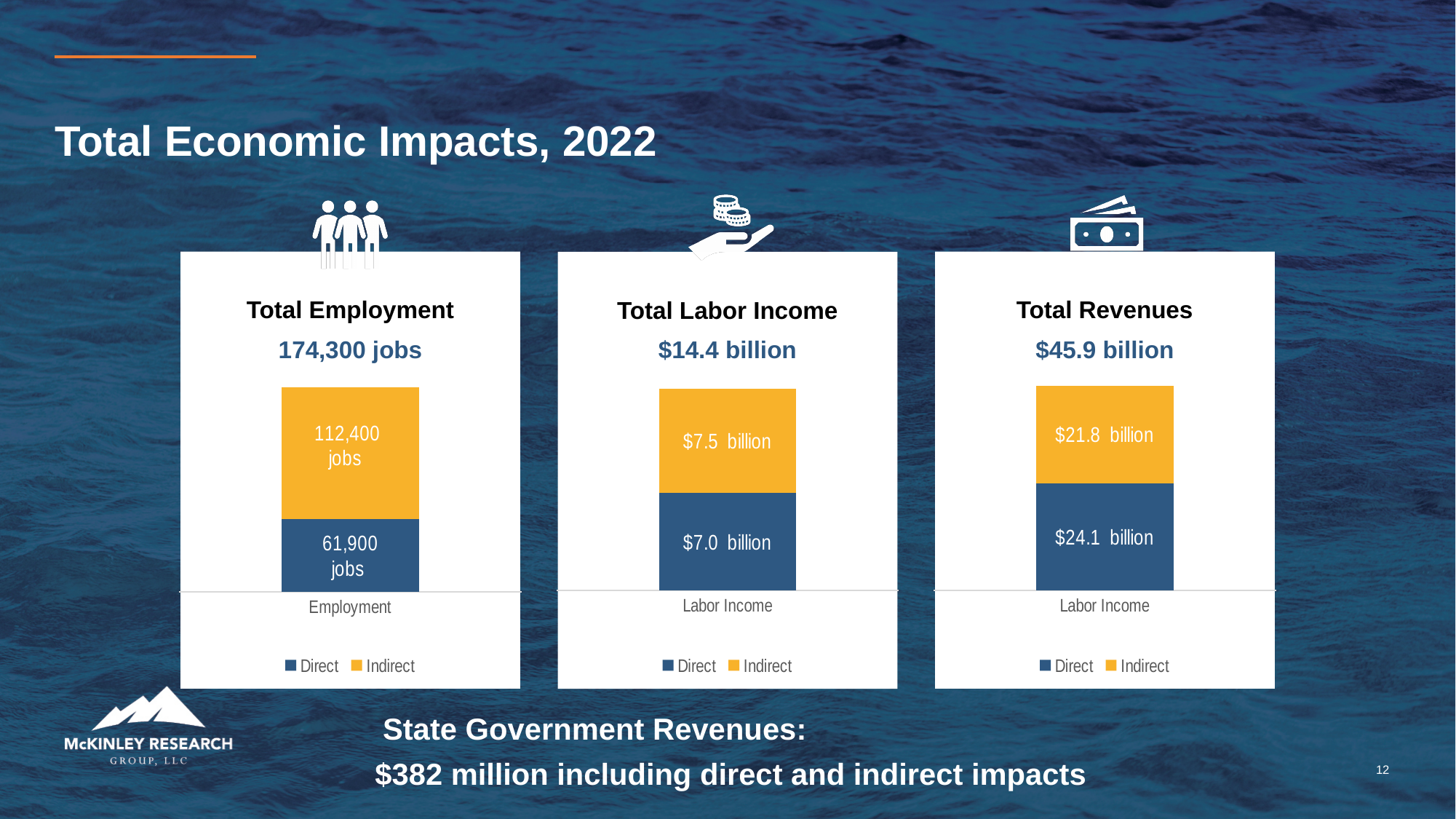
What kind of chart is the Total Employment chart? Stacked bar chart In the Total Revenues chart, what is the value of the Direct segment? $24.1 billion In the Total Employment chart, how many direct jobs are shown? 61,900 jobs In the Total Revenues chart, what is the value of the Indirect segment? $21.8 billion In the Total Employment chart, what is the total of the stacked bar? 174,300 jobs In the Total Employment chart, how many indirect jobs are shown? 112,400 jobs In the Total Revenues chart, which segment is larger, Direct or Indirect? Direct In the Total Labor Income chart, what is the value of the Indirect segment? $7.5 billion In the Total Employment chart, what is the difference between indirect and direct jobs? 50,500 jobs How many series does the legend of the Total Labor Income chart list? 2 In the Total Revenues chart, what is the total of the stacked bar? $45.9 billion In the Total Labor Income chart, what is the value of the Direct segment? $7.0 billion